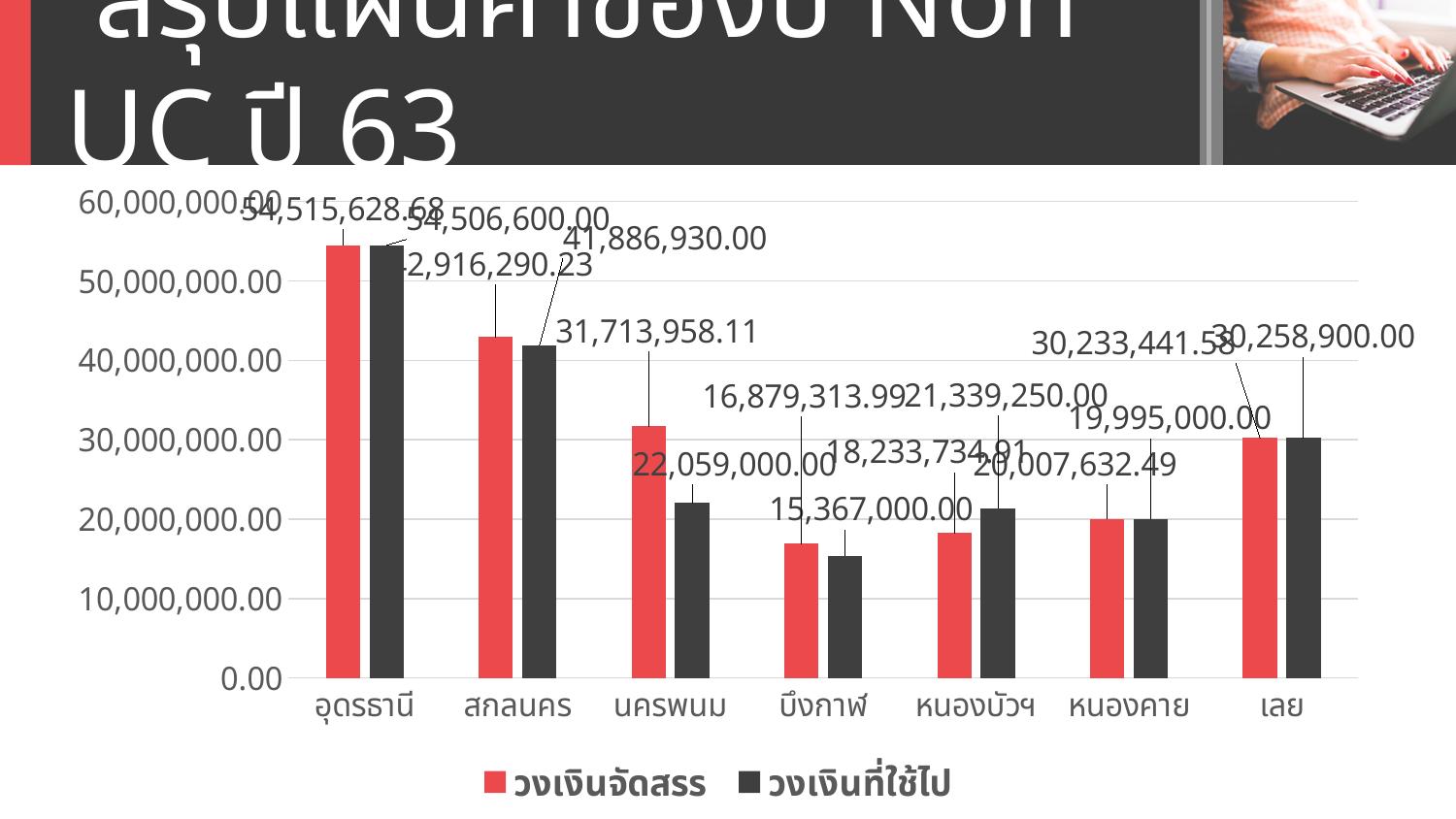
What is the วงเงินที่ใช้ไป value for นครพนม? 22,059,000.00 How many provinces (categories) are shown on the x axis of the chart? 7 What is the วงเงินจัดสรร value for เลย? 30,233,441.58 Is the วงเงินจัดสรร value for สกลนคร greater or less than 40,000,000.00? greater Which province has the lowest วงเงินที่ใช้ไป? บึงกาฬ What is the วงเงินที่ใช้ไป value for บึงกาฬ? 15,367,000.00 Which province has the highest วงเงินจัดสรร? อุดรธานี How many series does the chart legend list? 2 For หนองบัวฯ, which is larger: วงเงินจัดสรร or วงเงินที่ใช้ไป? วงเงินที่ใช้ไป What is the difference between วงเงินจัดสรร and วงเงินที่ใช้ไป for นครพนม? 9,654,958.11 What colour represents the วงเงินจัดสรร series in the chart? red What kind of chart is shown on the slide? bar chart